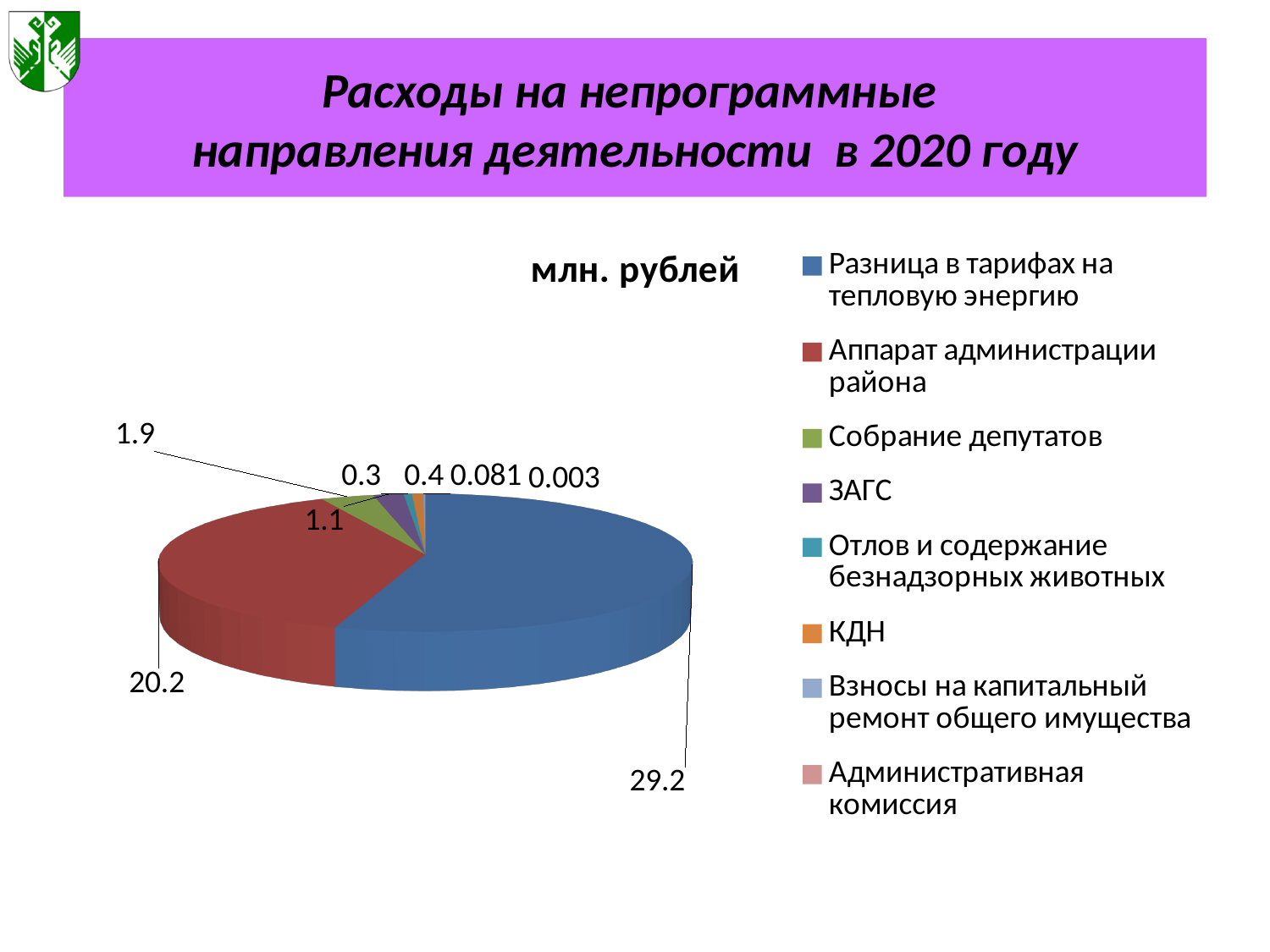
What is the value for Разница в тарифах на тепловую энергию? 29.2 What is the smallest value labelled on the pie chart? 0.003 Which category has the largest slice of the pie? Разница в тарифах на тепловую энергию What is the largest value labelled on the pie chart? 29.2 What kind of chart is shown on the slide? Pie chart What colour is the slice for Разница в тарифах на тепловую энергию? Blue What is the difference between the values for Разница в тарифах на тепловую энергию and Аппарат администрации района? 9.0 How many categories does the legend list? 8 What is the value for Аппарат администрации района? 20.2 What is the title shown above the pie chart? млн. рублей Which is larger: Разница в тарифах на тепловую энергию or Аппарат администрации района? Разница в тарифах на тепловую энергию